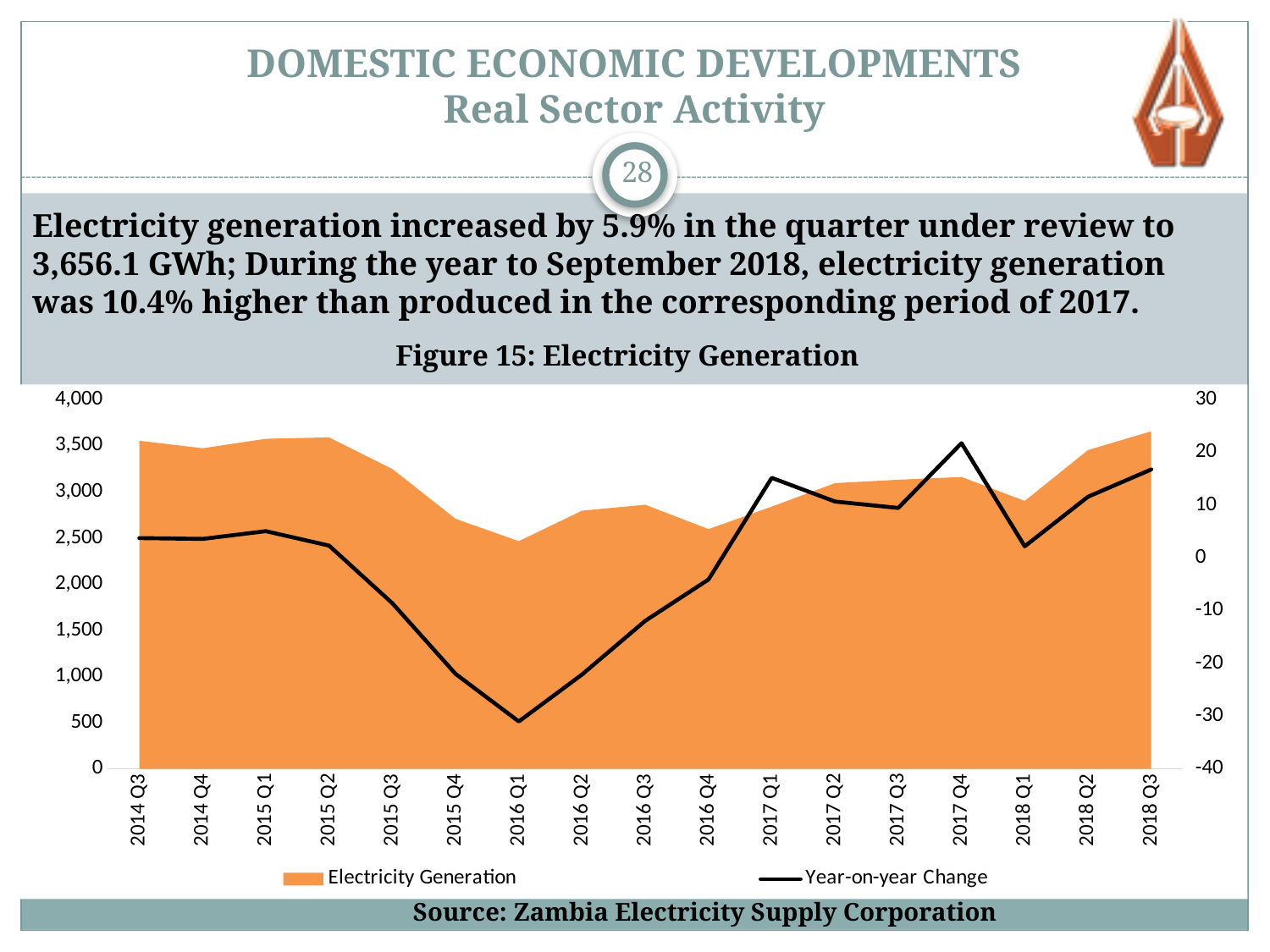
In which quarter is Electricity Generation at its lowest? 2016 Q1 Is the Year-on-year Change value for 2017 Q4 greater or less than 10? greater How many series does the legend list? 2 Does the Year-on-year Change rise or fall from 2016 Q1 to 2017 Q1? Rises How many quarters are plotted along the x axis? 17 Which is larger, Electricity Generation in 2015 Q2 or in 2016 Q1? 2015 Q2 What kind of chart is shown in Figure 15: Electricity Generation? An area chart with a line series What colour is the Electricity Generation area? Orange Is the Year-on-year Change value for 2016 Q1 greater or less than -20? less Is the Electricity Generation value for 2016 Q1 greater or less than 3,000? less In which quarter is the Year-on-year Change at its lowest? 2016 Q1 In which quarter is the Year-on-year Change at its highest? 2017 Q4